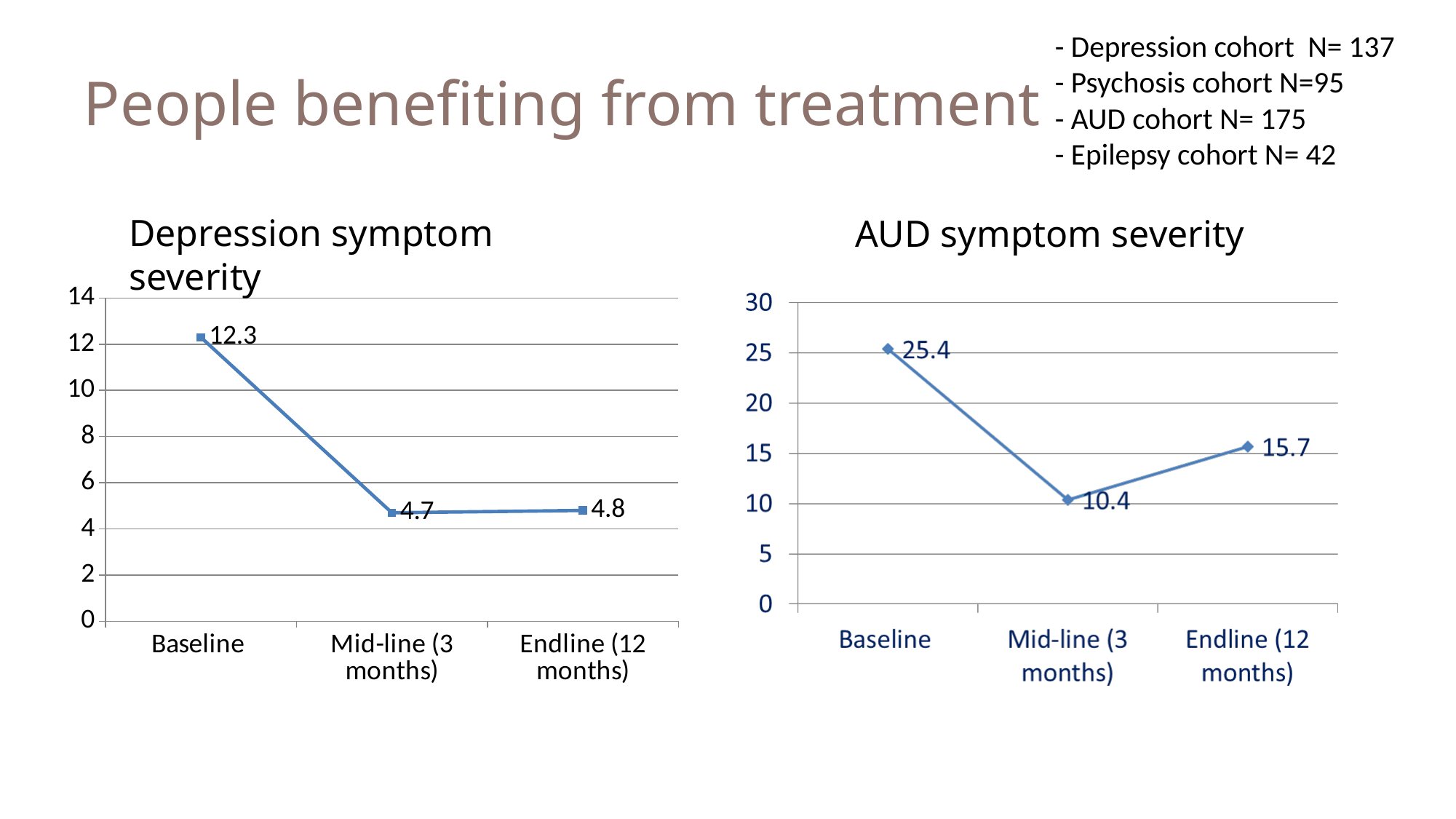
In the AUD symptom severity chart, what is the value at Endline (12 months)? 15.7 In the Depression symptom severity chart, what is the value at Mid-line (3 months)? 4.7 In the AUD symptom severity chart, which time point has the lowest value? Mid-line (3 months) In the AUD symptom severity chart, what is the difference between the Baseline and Mid-line (3 months) values? 15.0 In the AUD symptom severity chart, which is larger, the value at Mid-line (3 months) or at Endline (12 months)? Endline (12 months) What type of chart is the AUD symptom severity chart? Line chart How many time points are plotted in the Depression symptom severity chart? 3 In the Depression symptom severity chart, does the value rise or fall from Baseline to Mid-line (3 months)? Fall In the AUD symptom severity chart, which time point has the highest value? Baseline In the AUD symptom severity chart, what is the value at Mid-line (3 months)? 10.4 In the Depression symptom severity chart, what is the value at Baseline? 12.3 In the Depression symptom severity chart, what is the difference between the Baseline and Endline (12 months) values? 7.5